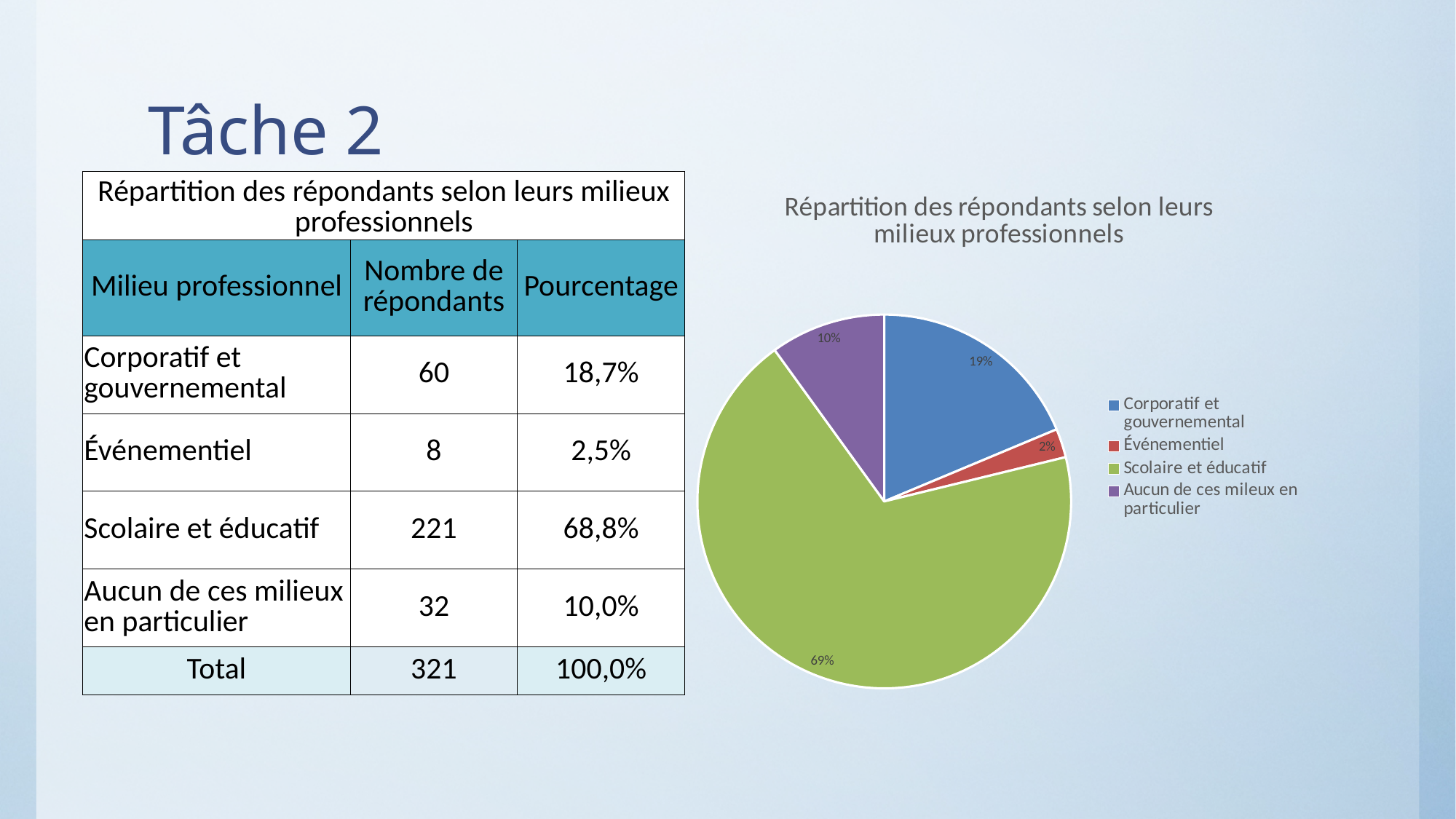
What kind of chart is shown on the slide? pie chart How many slices does the pie chart have? 4 Which slice is larger in the pie chart, Corporatif et gouvernemental or Aucun de ces mileux en particulier? Corporatif et gouvernemental What share of the pie does the Événementiel slice represent? 2% What share of the pie does the Corporatif et gouvernemental slice represent? 19% What share of the pie does the Scolaire et éducatif slice represent? 69% Which category has the largest slice in the pie chart? Scolaire et éducatif Which category has the smallest slice in the pie chart? Événementiel What colour is the Scolaire et éducatif slice in the pie chart? green How many entries does the pie chart's legend list? 4 What is the title of the pie chart? Répartition des répondants selon leurs milieux professionnels